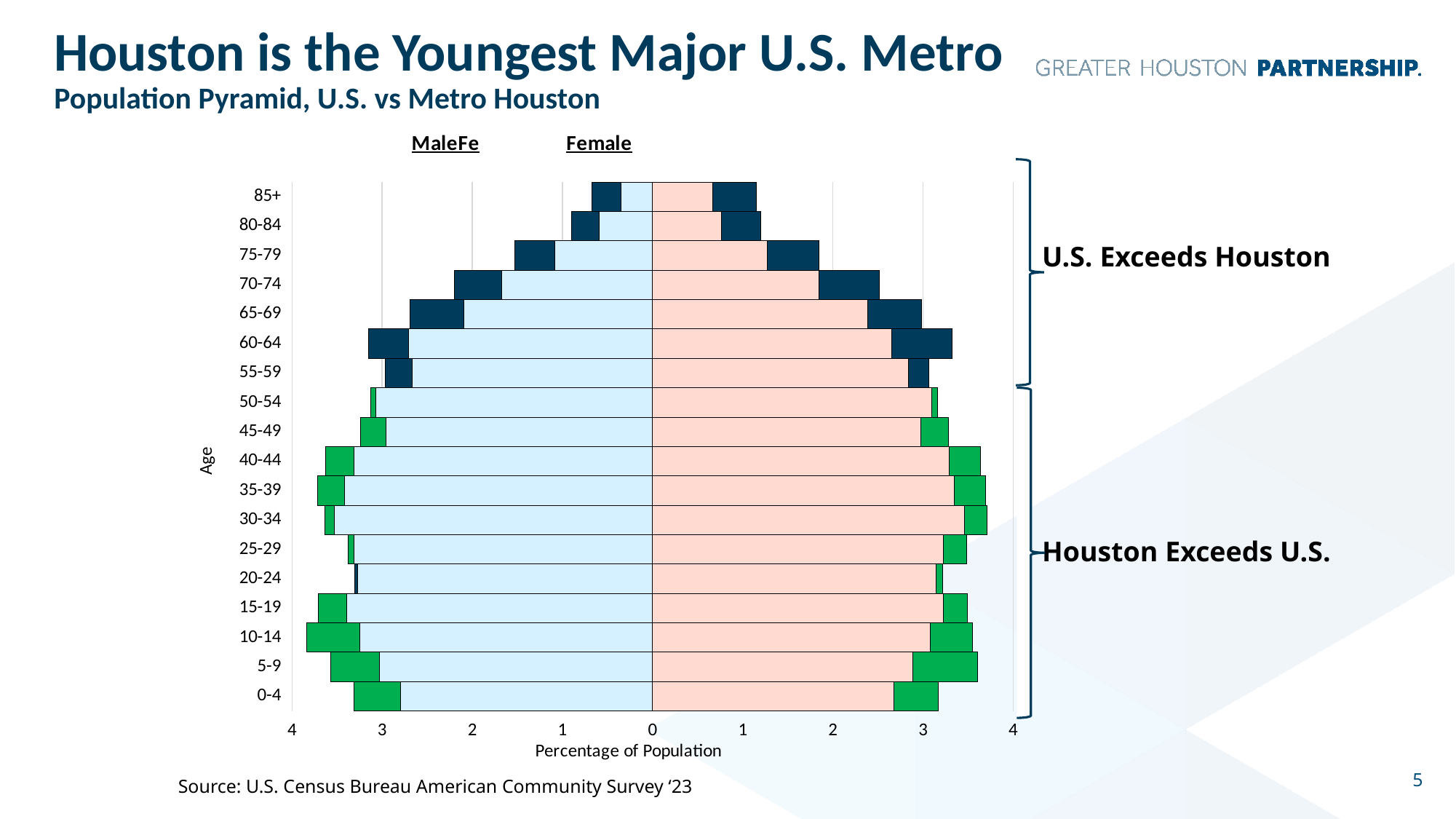
Which is longer on the male side of the pyramid: the bar for 85+ or the bar for 0-4? 0-4 Moving up the pyramid from the 55-59 age group to the 85+ age group, do the bars get longer or shorter? shorter Is the male bar for the 85+ age group greater or less than 1 on the percentage axis? less Is the female bar for the 70-74 age group greater or less than 2 on the percentage axis? greater How many age groups are listed on the vertical axis of the population pyramid? 18 Is the male bar for the 75-79 age group greater or less than 2 on the percentage axis? less Which age group has the shortest bars on both the male and female sides of the pyramid? 85+ What is the title of the horizontal axis of the population pyramid? Percentage of Population According to the annotation on the right of the chart, which region exceeds the other in the older age groups (55-59 and above)? U.S. Exceeds Houston What kind of chart is shown on the slide? Bar chart (population pyramid)